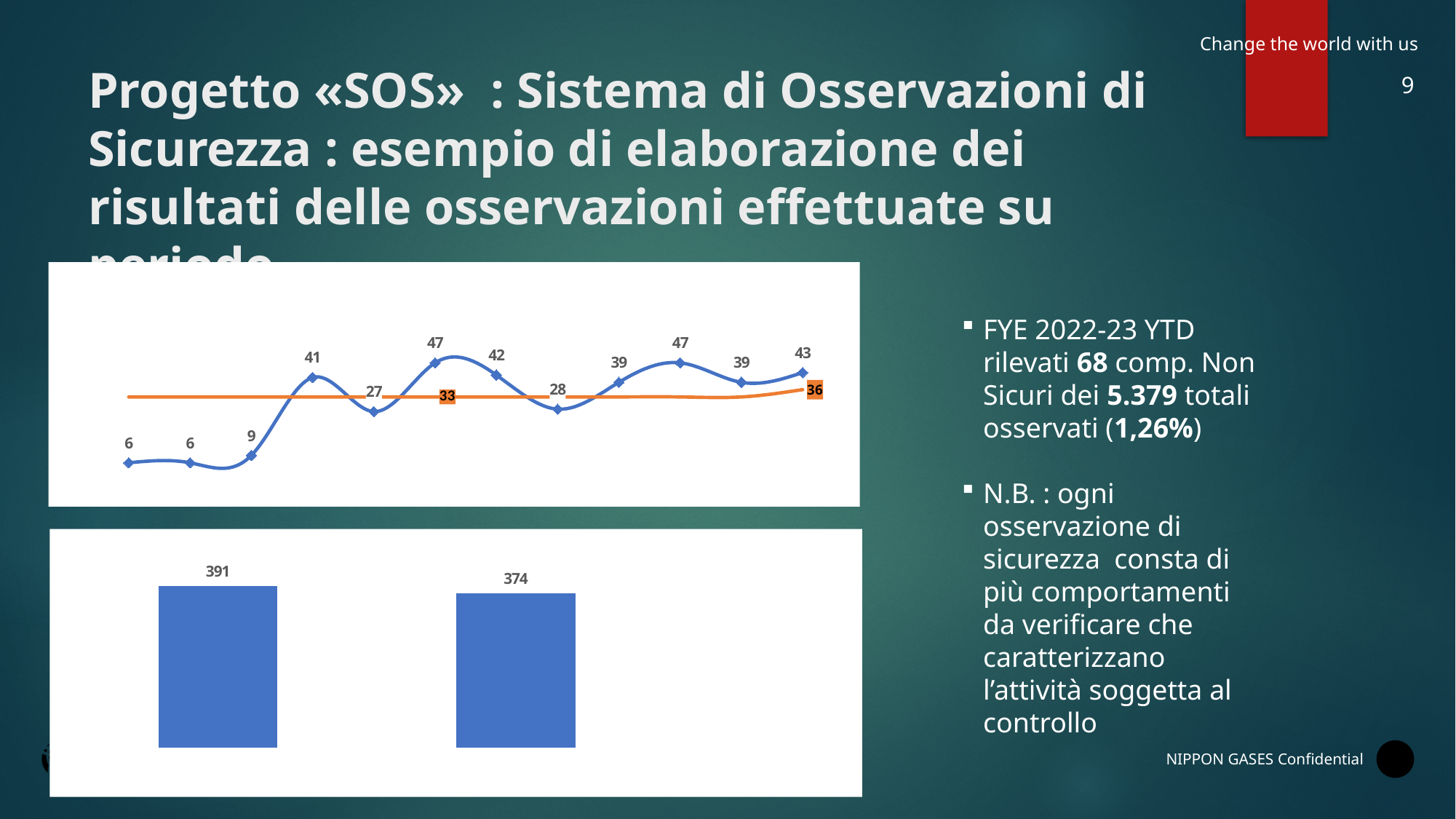
In the bottom chart, what is the value of the left bar? 391 In the top chart, what is the difference between the highest and lowest values on the blue line? 41 In the top chart, what is the value of the last (rightmost) point on the blue line? 43 In the bottom chart, which bar is taller, the left or the right? left In the top chart, what is the highest value labelled on the blue line? 47 In the top chart, what is the value of the last label on the orange line? 36 In the top chart, what is the value of the fourth point on the blue line? 41 In the top chart, what is the lowest value labelled on the blue line? 6 In the top chart, how many data points does the blue line have? 12 What kind of chart is the top chart on the slide? line chart In the bottom chart, what is the difference between the left bar and the right bar? 17 What kind of chart is the bottom chart on the slide? bar chart